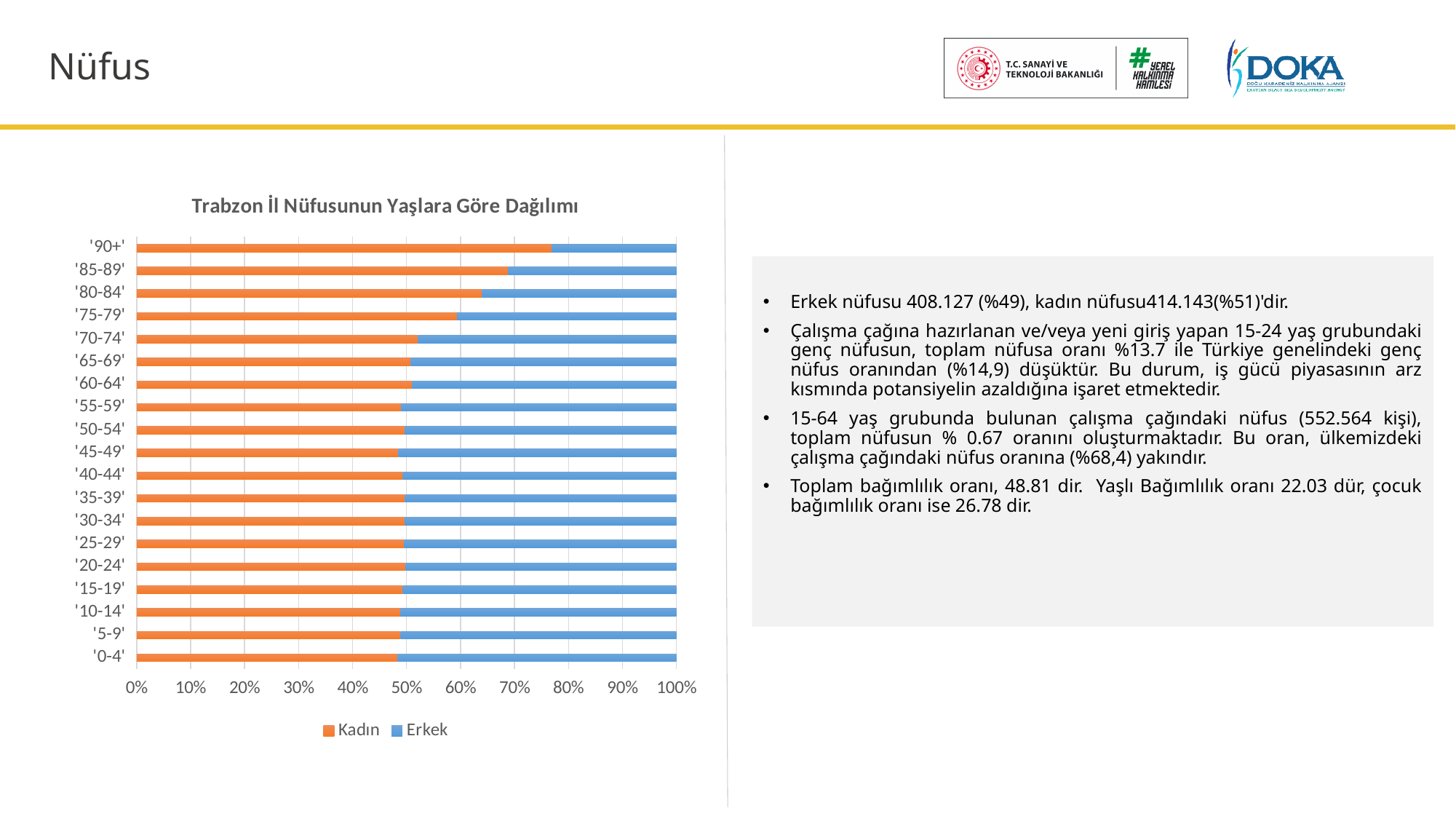
For the '90+' age group, which is larger, the Kadın share or the Erkek share? Kadın Which two series are listed in the chart legend? Kadın and Erkek Is the Erkek share for the '90+' age group greater or less than 30%? less How many age groups are shown on the chart? 19 Which age group has the highest Kadın share? '90+' Does the Kadın share rise or fall as the age groups get older? rise How many series does the chart legend list? 2 Is the Kadın share for the '90+' age group greater or less than 70%? greater Is the Kadın share for the '85-89' age group greater or less than 60%? greater What kind of chart is shown on the slide? bar chart Which age group has a larger Kadın share, '80-84' or '20-24'? '80-84' What is the title of the chart? Trabzon İl Nüfusunun Yaşlara Göre Dağılımı